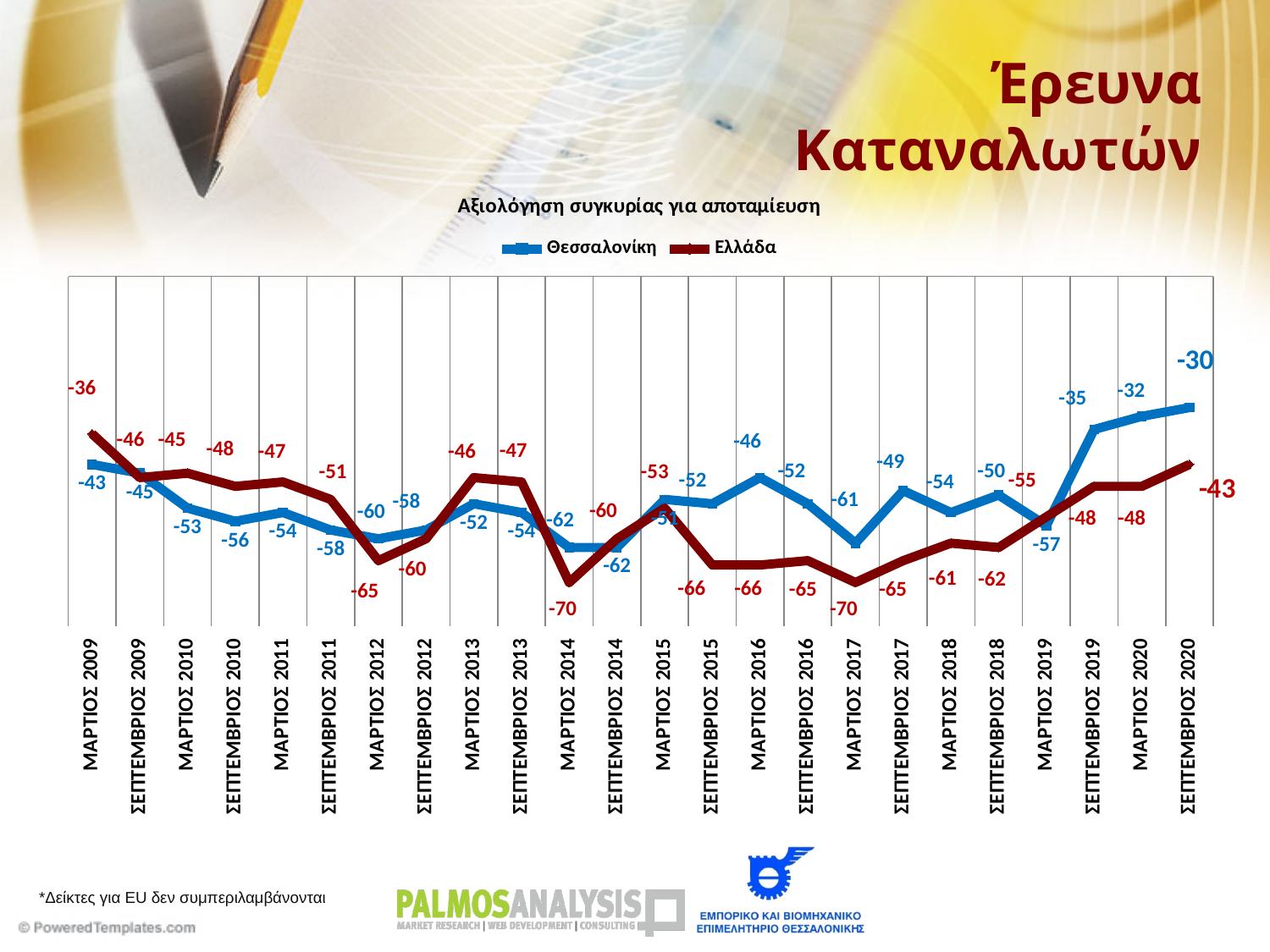
What is the value for Θεσσαλονίκη in ΣΕΠΤΕΜΒΡΙΟΣ 2020? -30 In which period does the Θεσσαλονίκη series reach its highest value? ΣΕΠΤΕΜΒΡΙΟΣ 2020 What is the difference between the Θεσσαλονίκη and Ελλάδα values in ΣΕΠΤΕΜΒΡΙΟΣ 2020? 13 What is the value for Ελλάδα in ΣΕΠΤΕΜΒΡΙΟΣ 2020? -43 What is the value for Θεσσαλονίκη in ΜΑΡΤΙΟΣ 2012? -60 What kind of chart is shown on the slide? Line chart In ΜΑΡΤΙΟΣ 2016, which series has the higher value, Θεσσαλονίκη or Ελλάδα? Θεσσαλονίκη What is the lowest value shown for the Θεσσαλονίκη series? -62 In which period does the Ελλάδα series reach its highest value? ΜΑΡΤΙΟΣ 2009 How many series does the legend list? 2 What is the value for Ελλάδα in ΜΑΡΤΙΟΣ 2009? -36 How many time periods are shown on the x axis? 24